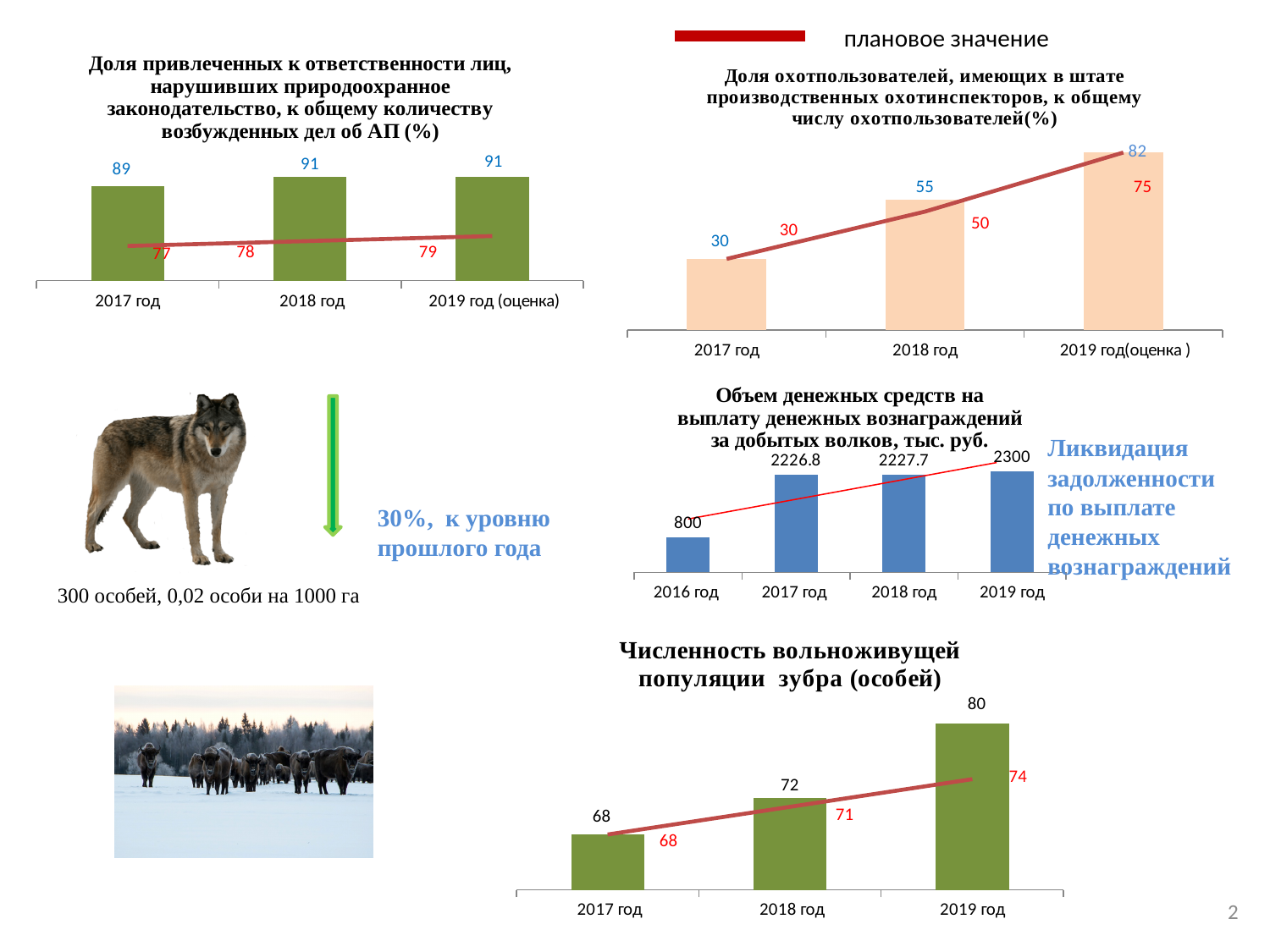
In the chart 'Доля привлеченных к ответственности лиц...' (top left), what is the planned value (плановое значение) for 2019 год (оценка)? 79 What type of chart is 'Численность вольноживущей популяции зубра (особей)'? bar chart In the chart 'Доля привлеченных к ответственности лиц...' (top left), what is the value for 2018 год? 91 In the chart 'Доля охотпользователей, имеющих в штате производственных охотинспекторов...' (top right), what is the value for 2018 год? 55 In the chart 'Доля охотпользователей, имеющих в штате производственных охотинспекторов...' (top right), which year has the highest bar? 2019 год(оценка ) In the chart 'Доля привлеченных к ответственности лиц...' (top left), how many years are shown on the x axis? 3 In the chart 'Доля охотпользователей, имеющих в штате производственных охотинспекторов...' (top right), do the bar values rise or fall from 2017 to 2019? rise In the chart 'Доля охотпользователей, имеющих в штате производственных охотинспекторов...' (top right), what is the difference between the actual value and the planned value for 2019 год(оценка )? 7 In the chart 'Численность вольноживущей популяции зубра (особей)', what is the value for 2019 год? 80 In the chart 'Объем денежных средств на выплату денежных вознаграждений за добытых волков, тыс. руб.', which year has the lowest value? 2016 год In the chart 'Численность вольноживущей популяции зубра (особей)', what is the difference between the values for 2019 год and 2017 год? 12 In the chart 'Объем денежных средств на выплату денежных вознаграждений за добытых волков, тыс. руб.', what is the value for 2017 год? 2226.8